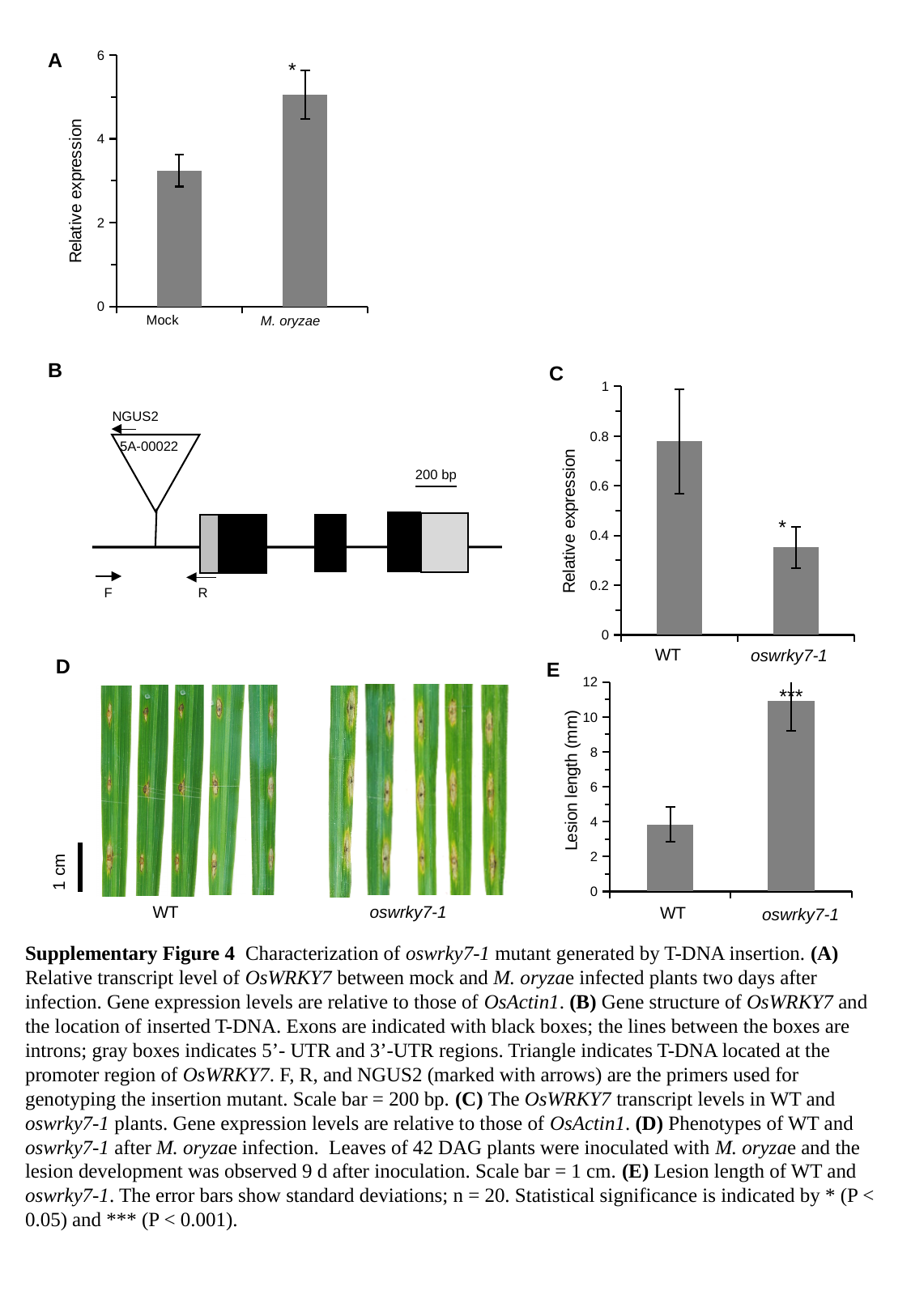
In chart E, which category has the higher lesion length, WT or oswrky7-1? oswrky7-1 In chart C, is the value for WT greater or less than 0.6? greater In chart A (top), which category has the higher relative expression, Mock or M. oryzae? M. oryzae In chart C, is the value for oswrky7-1 greater or less than 0.2? greater In chart A (top), is the value for M. oryzae greater or less than 4? greater What kind of chart is chart E? bar chart In chart C, which category has the lower relative expression, WT or oswrky7-1? oswrky7-1 In chart A (top), how many categories are plotted on the x axis? 2 What is the y-axis label of chart E? Lesion length (mm)